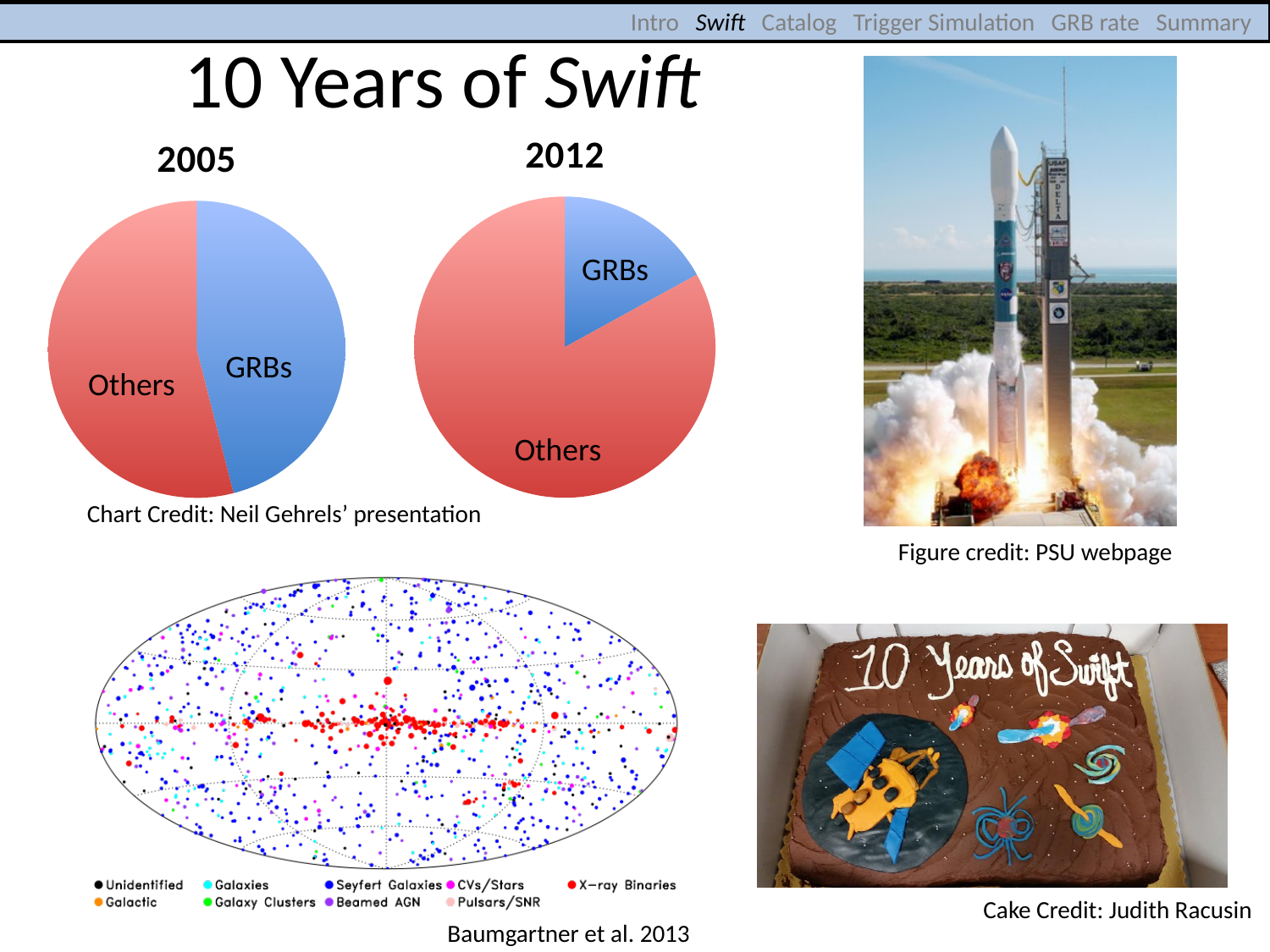
Which slice is the smallest in the 2012 pie chart? GRBs How many categories does the legend of the sky map chart at the bottom left list? 9 In the 2012 pie chart, which slice is larger, GRBs or Others? Others How many slices does the 2005 pie chart have? 2 What type of chart is the 2005 chart on the slide? pie chart In the legend of the sky map chart at the bottom left, what colour marks X-ray Binaries? red From the 2005 pie chart to the 2012 pie chart, does the share of GRBs rise or fall? fall How many slices does the 2012 pie chart have? 2 In the 2005 pie chart, which slice is larger, GRBs or Others? Others Comparing the 2005 and 2012 pie charts, which year has the smaller GRBs slice? 2012 According to the slide, who is credited for the pie charts? Neil Gehrels' presentation Which slice is the largest in the 2012 pie chart? Others